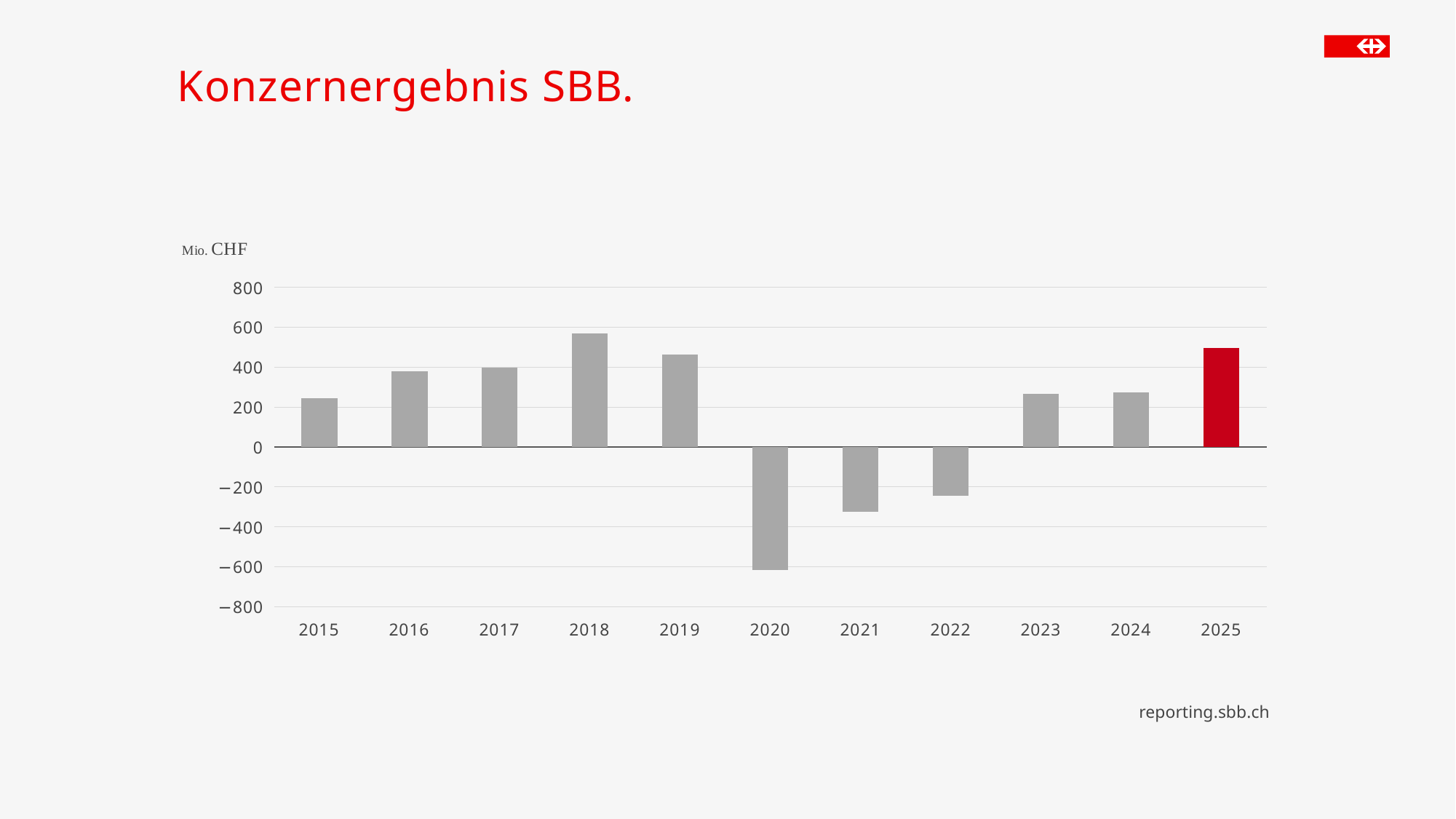
Is the value for 2020 greater or less than -400? less Which year's bar is highlighted in red? 2025 Which year has the lowest value in the chart? 2020 Do the values rise or fall from 2015 to 2018? rise What kind of chart is shown on the slide? bar chart Is the value for 2018 greater or less than 400? greater Which year has the larger value, 2024 or 2025? 2025 How many years are shown on the x axis of the chart? 11 Is the value for 2022 greater or less than -400? greater Which year has the larger value, 2018 or 2019? 2018 Which year has the highest value in the chart? 2018